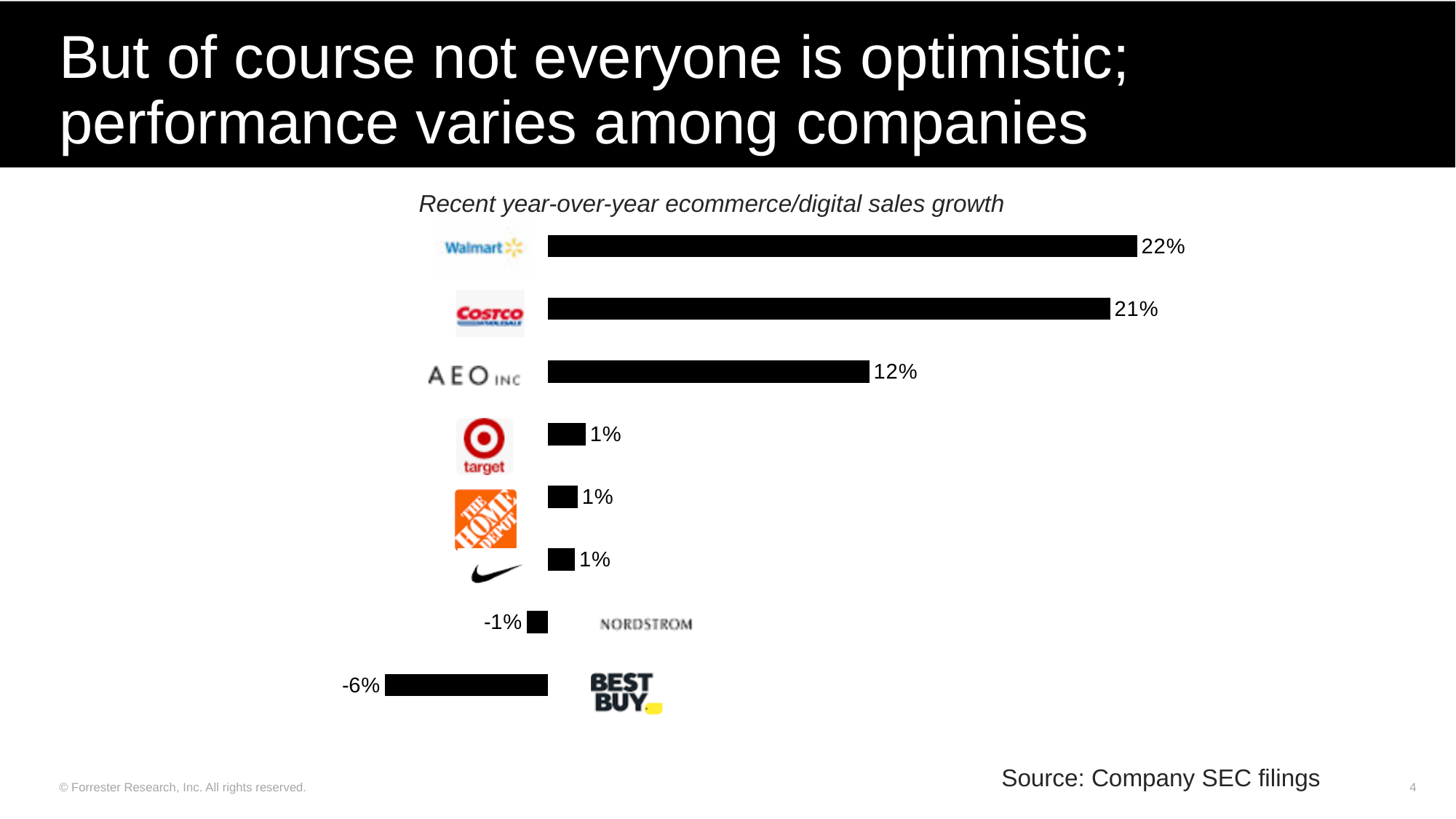
Which company has the highest ecommerce/digital sales growth on the chart? Walmart What is the year-over-year ecommerce/digital sales growth shown for Costco? 21% What is the year-over-year ecommerce/digital sales growth shown for Nordstrom? -1% Which company has the lowest ecommerce/digital sales growth on the chart? Best Buy What is the year-over-year ecommerce/digital sales growth shown for Best Buy? -6% What is the difference between Walmart's and AEO Inc's ecommerce/digital sales growth? 10% What kind of chart is shown on the slide? Bar chart What is the title of the chart? Recent year-over-year ecommerce/digital sales growth What is the year-over-year ecommerce/digital sales growth shown for Walmart? 22% How many companies are shown on the chart? 8 What is the year-over-year ecommerce/digital sales growth shown for AEO Inc? 12% Which has higher ecommerce/digital sales growth, Costco or AEO Inc? Costco